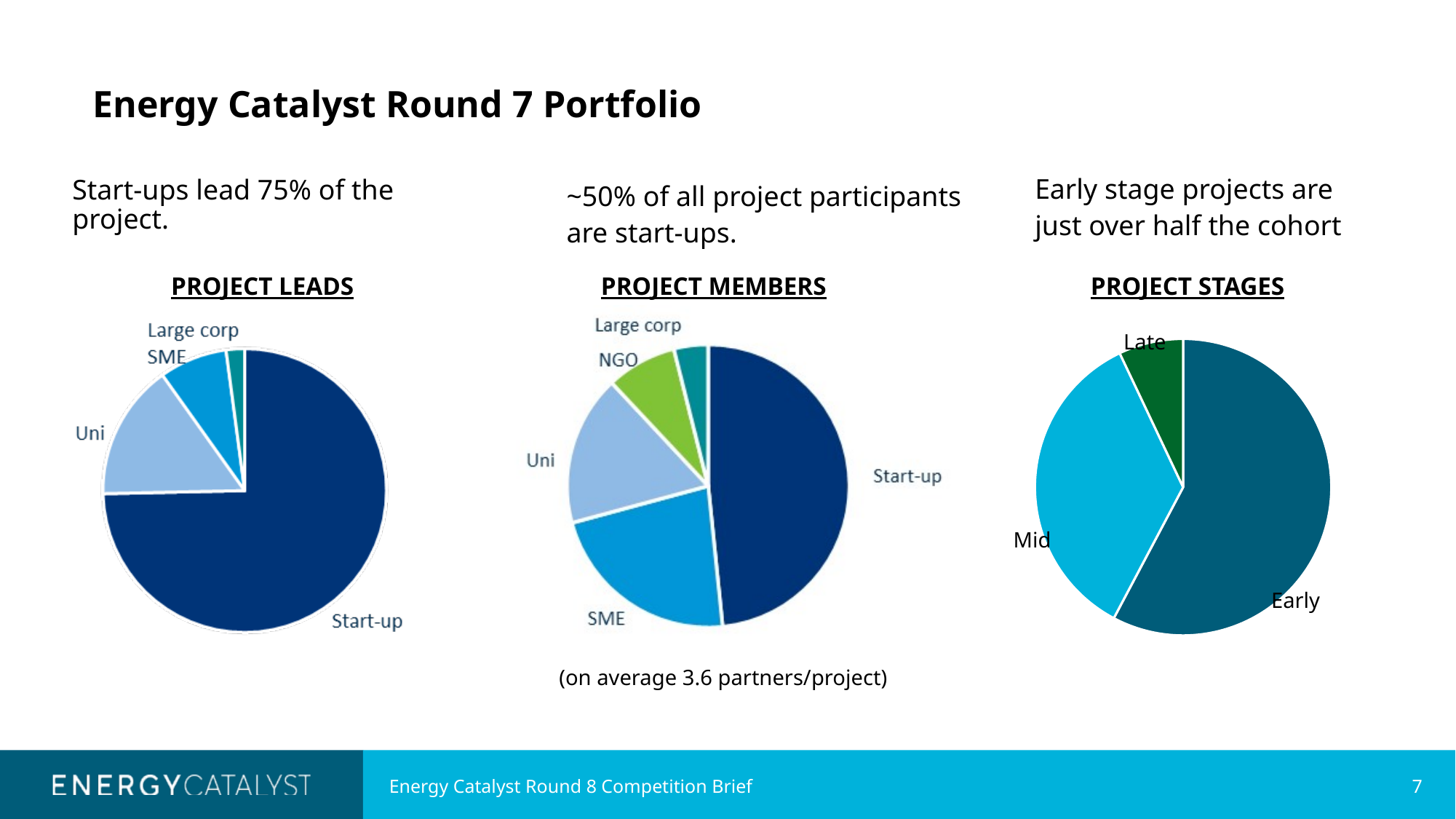
In the PROJECT MEMBERS chart, which slice is larger, SME or NGO? SME In the PROJECT MEMBERS chart, which category has the smallest slice? Large corp In the PROJECT LEADS chart, which category has the smallest slice? Large corp In the PROJECT LEADS chart, which category has the largest slice? Start-up What kind of chart is the PROJECT LEADS chart? Pie chart How many slices does the PROJECT LEADS pie chart have? 4 In the PROJECT STAGES chart, which stage has the smallest slice? Late How many slices does the PROJECT STAGES pie chart have? 3 How many slices does the PROJECT MEMBERS pie chart have? 5 In the PROJECT STAGES chart, which slice is larger, Early or Mid? Early In the PROJECT MEMBERS chart, which category has the largest slice? Start-up In the PROJECT LEADS chart, what share of the pie does Start-up take, according to the slide text? 75%